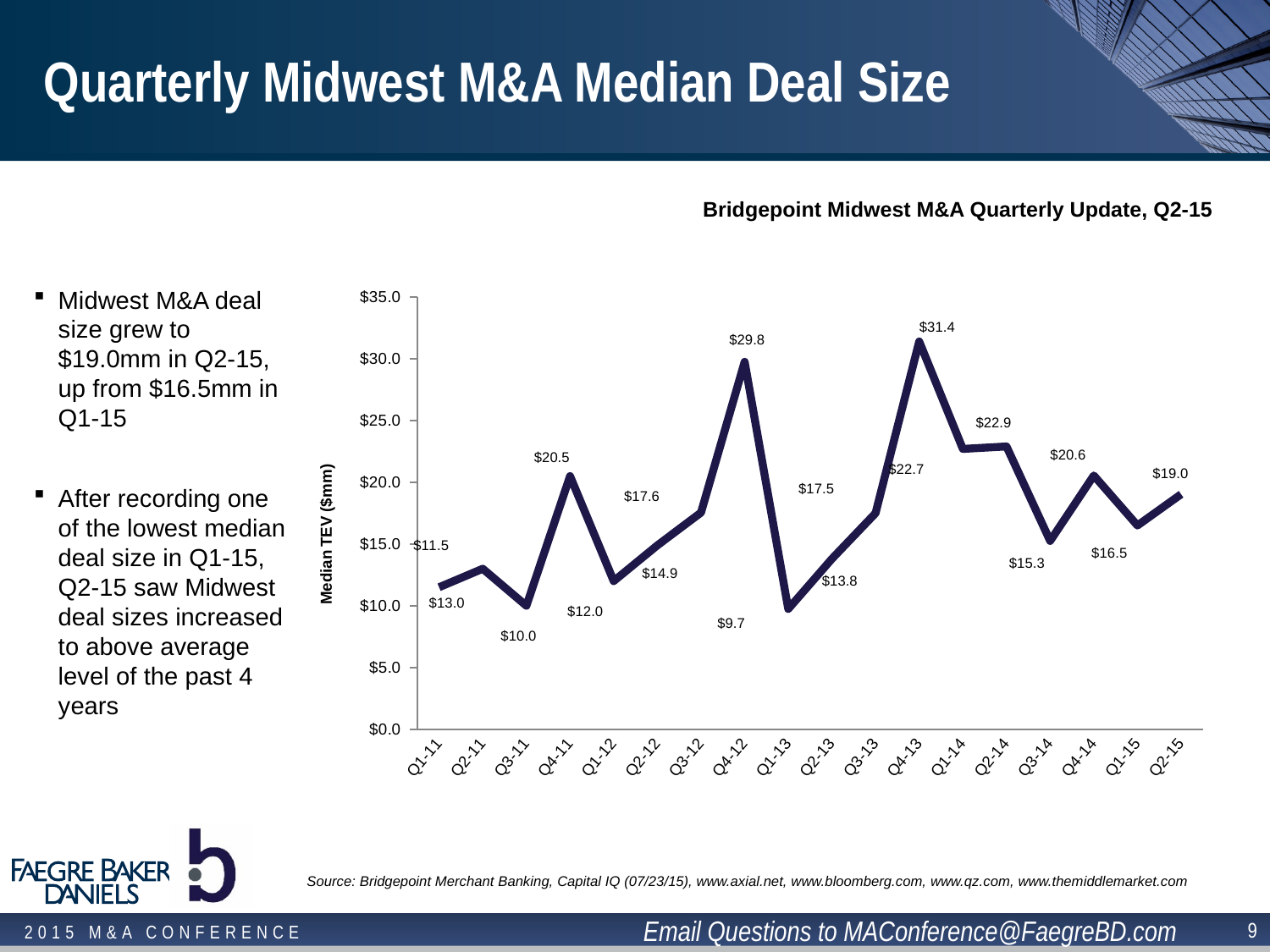
What is the difference between the median deal size in Q2-15 and Q1-15? $2.5 What is the median deal size for Q2-15? $19.0 Which quarter has the highest median deal size? Q4-13 What is the label on the y axis? Median TEV ($mm) How many quarters are plotted on the x axis? 18 What is the median deal size for Q4-12? $29.8 What kind of chart is shown on the slide? line chart What is the median deal size for Q3-11? $10.0 Which quarter has the lowest median deal size? Q1-13 Which is larger, the median deal size in Q4-11 or in Q4-14? Q4-14 Is the value for Q1-14 greater or less than $20.0? greater What is the difference between the median deal size in Q4-13 and Q1-13? $21.7